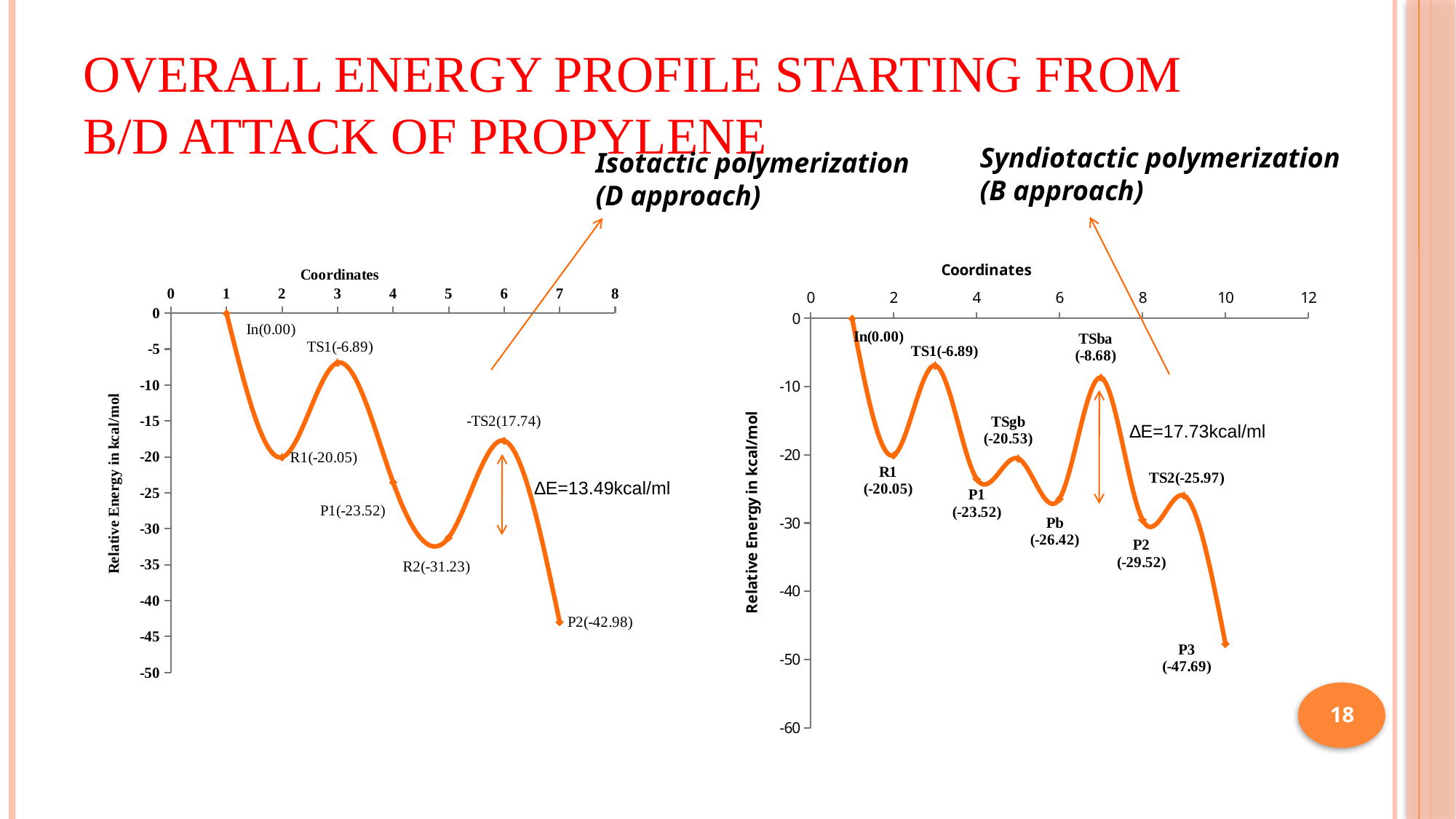
In the Isotactic polymerization (D approach) chart, what is the relative energy labeled for R2? -31.23 What kind of chart is the Isotactic polymerization (D approach) chart? line chart How many labeled points are shown on the Syndiotactic polymerization (B approach) chart? 10 In the Syndiotactic polymerization (B approach) chart, which has the higher relative energy, TSgb or TS2? TSgb In the Isotactic polymerization (D approach) chart, which labeled point has the highest relative energy? In In the Isotactic polymerization (D approach) chart, is the relative energy of P1 greater or less than -20? less In the Syndiotactic polymerization (B approach) chart, what is the relative energy labeled for P3? -47.69 What ΔE value is annotated on the Syndiotactic polymerization (B approach) chart? ΔE=17.73kcal/ml In the Syndiotactic polymerization (B approach) chart, what is the relative energy labeled for TSba? -8.68 In the Syndiotactic polymerization (B approach) chart, what is the difference in relative energy between Pb and P2? 3.10 In the Syndiotactic polymerization (B approach) chart, which labeled point has the lowest relative energy? P3 In the Isotactic polymerization (D approach) chart, what is the relative energy labeled for P2? -42.98